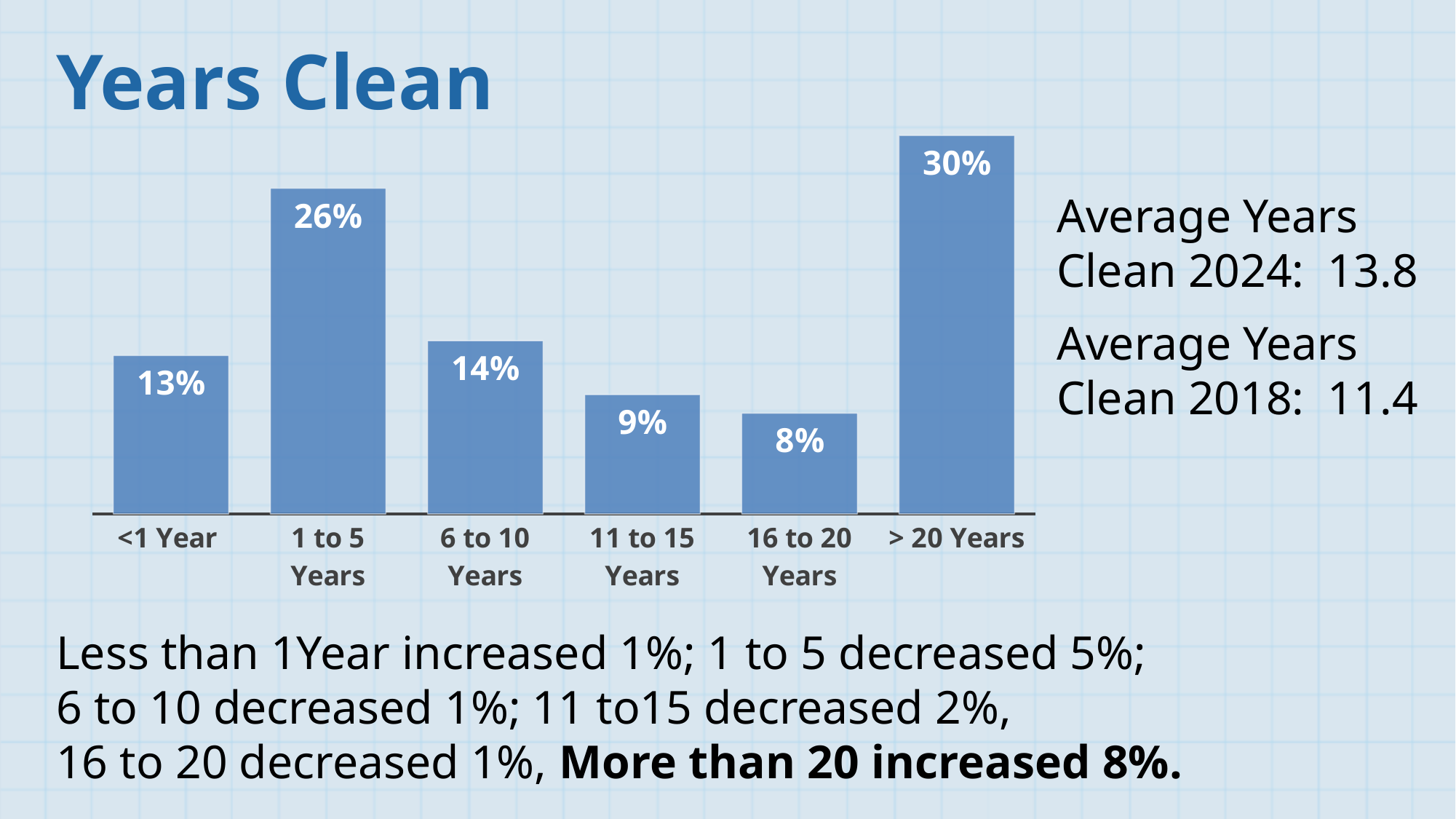
What is the difference between the 6 to 10 Years value and the 11 to 15 Years value? 5% What is the title of the slide containing the chart? Years Clean What percentage is shown for the <1 Year category? 13% Which category has the highest value? > 20 Years Which is larger, the value for <1 Year or the value for 6 to 10 Years? 6 to 10 Years What percentage is shown for 16 to 20 Years? 8% How many categories are shown on the chart? 6 What is the total of the 11 to 15 Years and 16 to 20 Years values? 17% Which category has the lowest value? 16 to 20 Years What is the difference between the > 20 Years value and the 1 to 5 Years value? 4% What kind of chart is shown on the slide? Bar chart What is the value for the 1 to 5 Years category? 26%